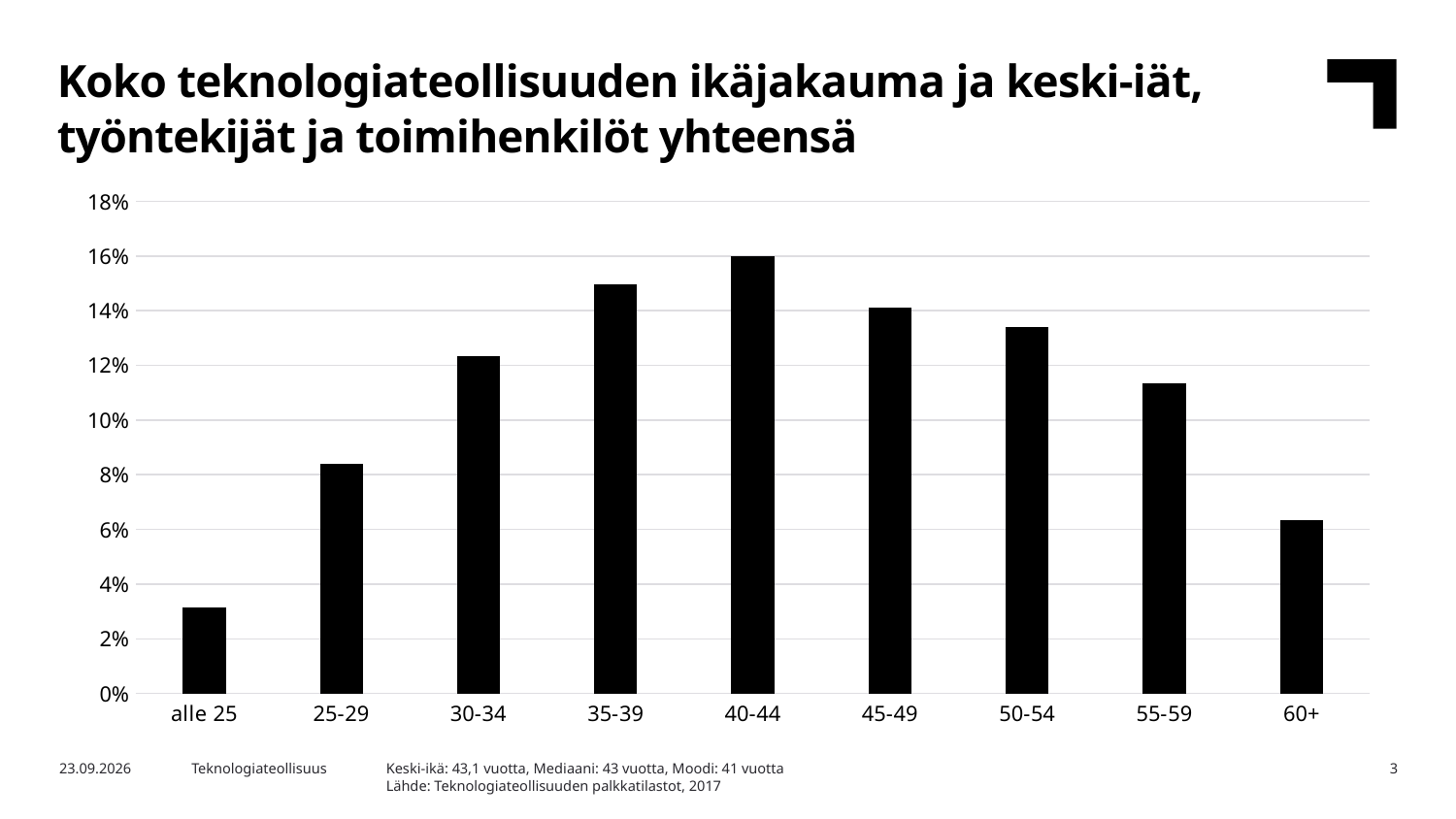
Is the value for 40-44 greater or less than 14%? greater Which age group has the highest share? 40-44 Do the values rise or fall from 40-44 to 60+ along the x axis? fall What kind of chart is shown on the slide? bar chart Which is larger, the value for 30-34 or the value for 50-54? 50-54 How many age groups are shown on the x axis? 9 Is the value for 55-59 greater or less than 10%? greater Which is larger, the value for 25-29 or the value for 60+? 25-29 Is the value for 25-29 greater or less than 10%? less Which age group has the lowest share? alle 25